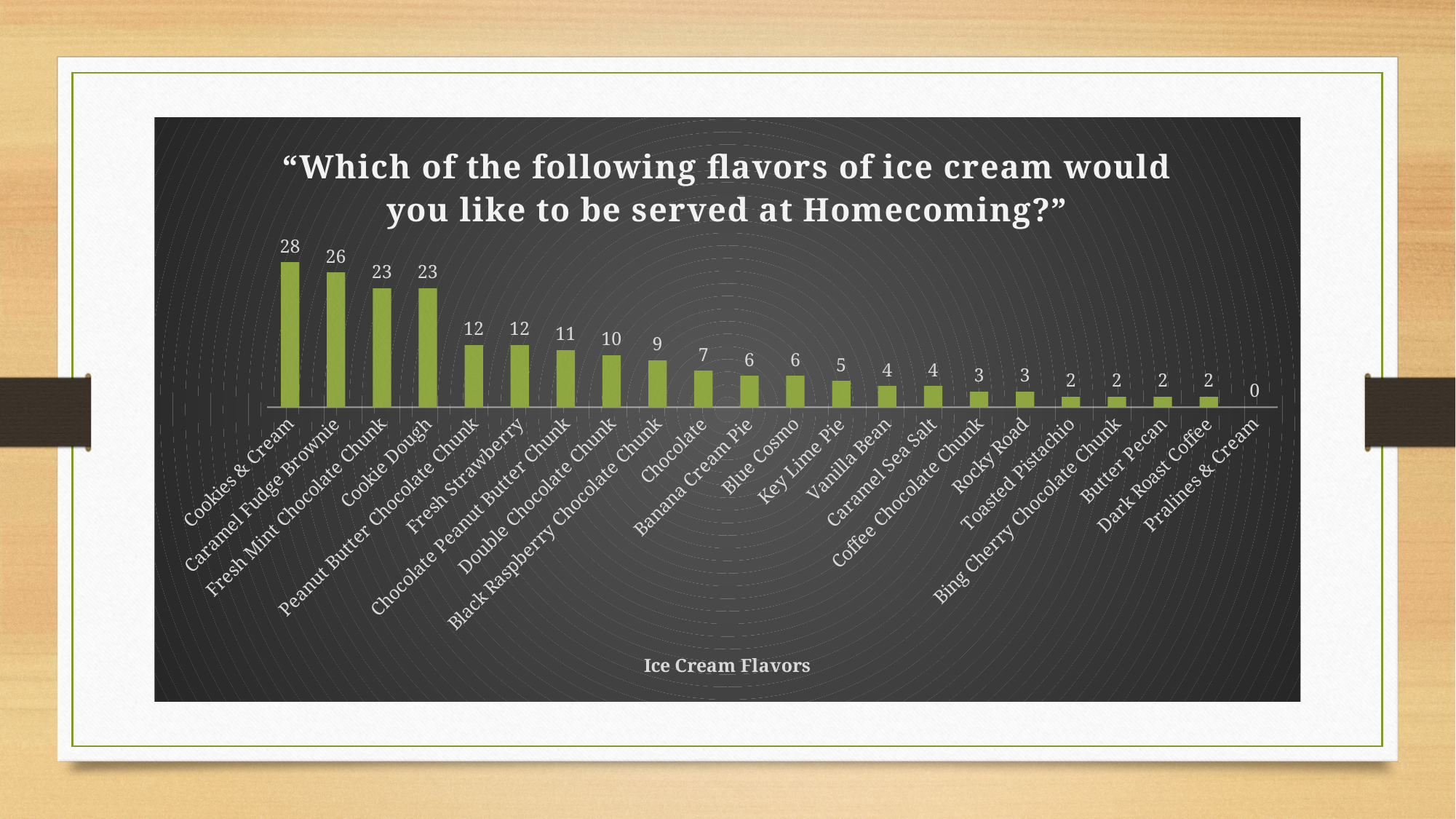
What is the value for Black Raspberry Chocolate Chunk? 9 How many flavors are shown on the chart? 22 What is the value for Pralines & Cream? 0 Which flavor has the lowest value? Pralines & Cream How many votes did Cookies & Cream receive? 28 What is the difference between the values for Cookies & Cream and Cookie Dough? 5 What is the x-axis title of the chart? Ice Cream Flavors Which flavor has the highest value? Cookies & Cream What kind of chart is shown on the slide? Bar chart Which has a larger value, Chocolate or Key Lime Pie? Chocolate What is the value for Caramel Fudge Brownie? 26 Do the values rise or fall from left to right along the x axis? Fall